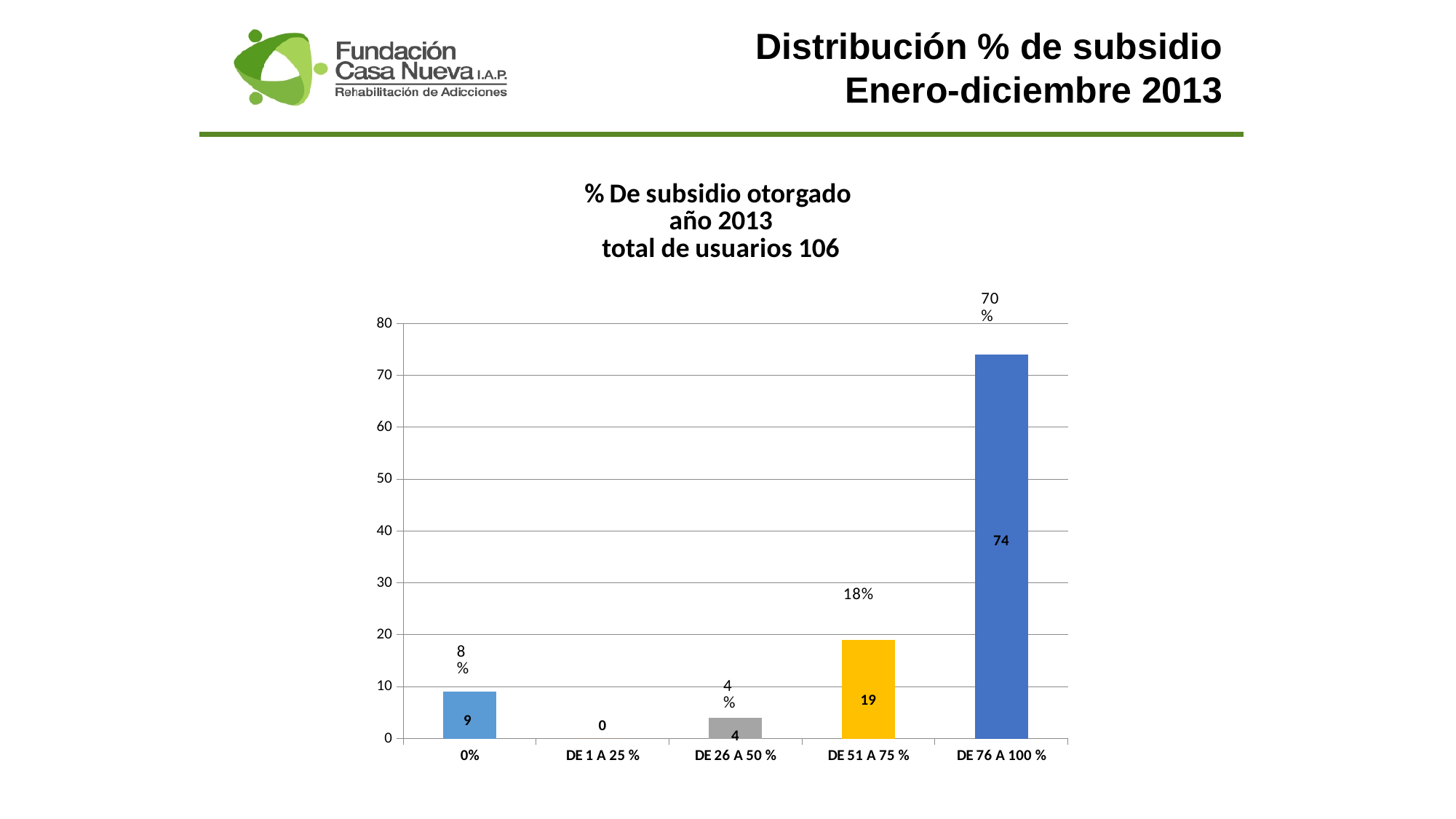
What is the value for the '0%' category? 9 Which category has the lowest value? DE 1 A 25 % How many categories are shown on the x axis? 5 What is the value for the 'DE 1 A 25 %' category? 0 What is the value for the 'DE 51 A 75 %' category? 19 What percentage label is shown above the 'DE 51 A 75 %' bar? 18% What kind of chart is shown on the slide? Bar chart Which is larger, the value for '0%' or the value for 'DE 26 A 50 %'? 0% What is the value for the 'DE 76 A 100 %' category? 74 Which category has the highest value? DE 76 A 100 % What is the difference between the values for 'DE 76 A 100 %' and 'DE 51 A 75 %'? 55 What is the value for the 'DE 26 A 50 %' category? 4